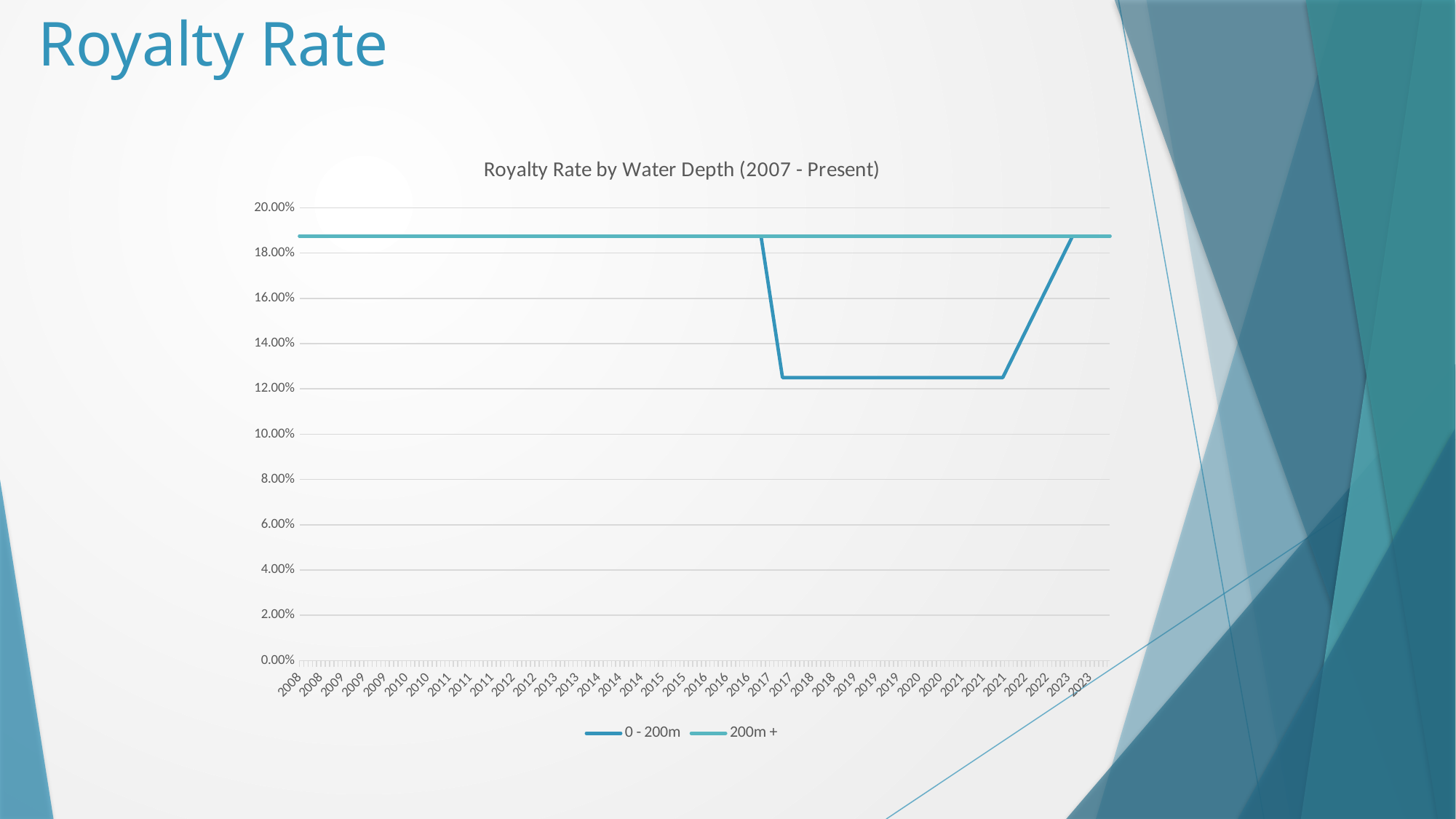
Is the value for 0 - 200m in 2019 greater or less than 12.00%? greater How many series does the legend list? 2 What kind of chart is shown on the slide? line chart Does the 0 - 200m series rise or fall between 2017 and 2018? fall What are the two series named in the legend? 0 - 200m and 200m + Does the 0 - 200m series rise or fall between 2021 and 2023? rise In 2018, which series has the higher value, 0 - 200m or 200m +? 200m + Is the value for 200m + in 2020 greater or less than 16.00%? greater Is the value for 200m + in 2010 greater or less than 18.00%? greater Does the 200m + series rise, fall, or stay flat across the years shown? stay flat What is the title of the chart? Royalty Rate by Water Depth (2007 - Present)